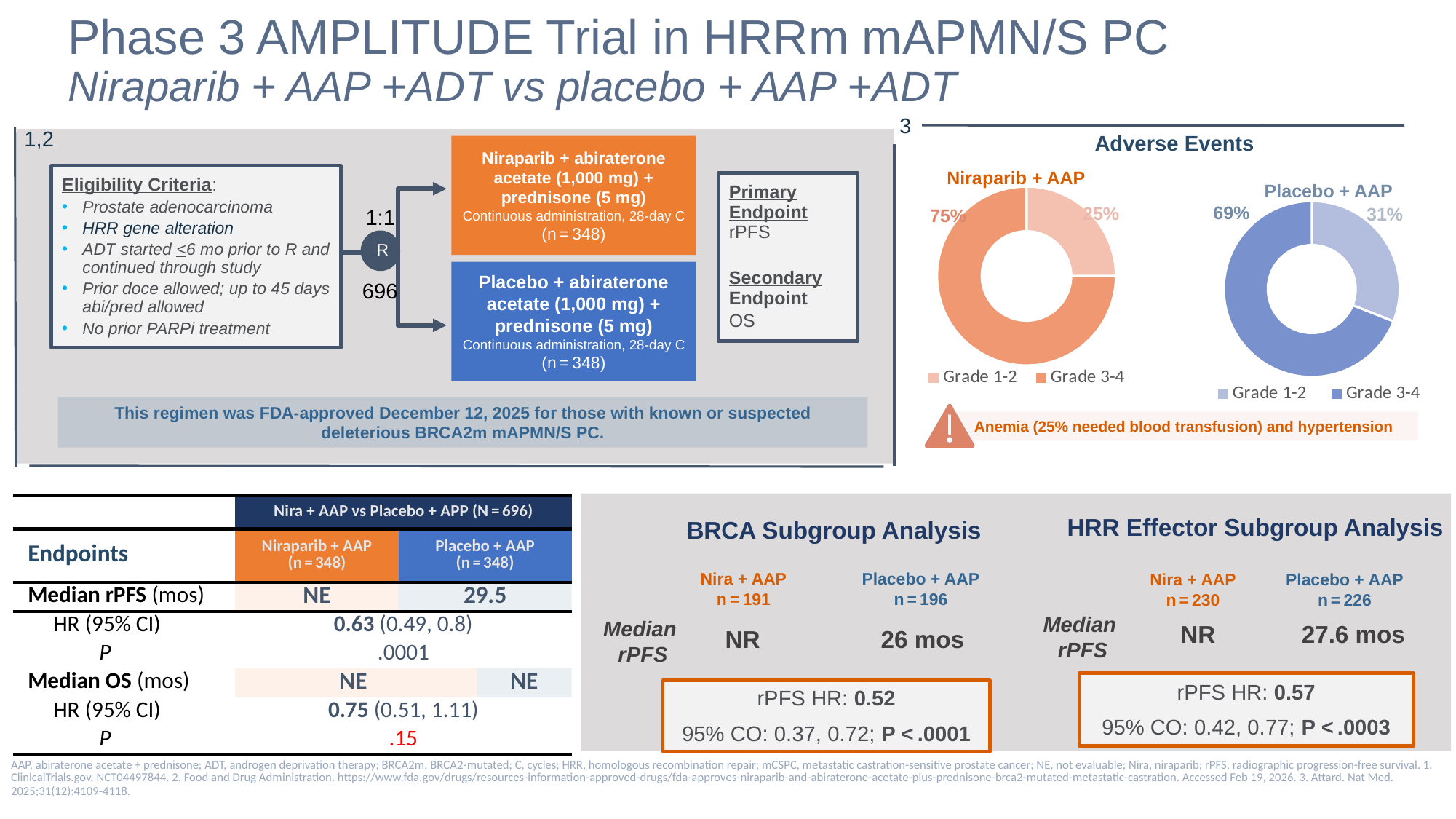
In the Placebo + AAP adverse events chart, what percentage is Grade 3-4? 69% How many categories does the Niraparib + AAP adverse events chart show? 2 Which is larger: the Grade 1-2 share in the Niraparib + AAP chart or the Grade 1-2 share in the Placebo + AAP chart? Placebo + AAP In the Placebo + AAP adverse events chart, which grade category has the smallest share? Grade 1-2 What kind of chart is used to show the adverse events for Niraparib + AAP? Pie (donut) chart What is the difference between the Grade 3-4 share in the Niraparib + AAP chart and the Grade 3-4 share in the Placebo + AAP chart? 6% What is the title above the two adverse events charts? Adverse Events How many entries does the legend of the Placebo + AAP adverse events chart list? 2 In the Niraparib + AAP adverse events chart, which grade category has the largest share? Grade 3-4 In the Niraparib + AAP adverse events chart, what percentage is Grade 1-2? 25% In the Niraparib + AAP adverse events chart, what percentage is Grade 3-4? 75% In the Placebo + AAP adverse events chart, what percentage is Grade 1-2? 31%